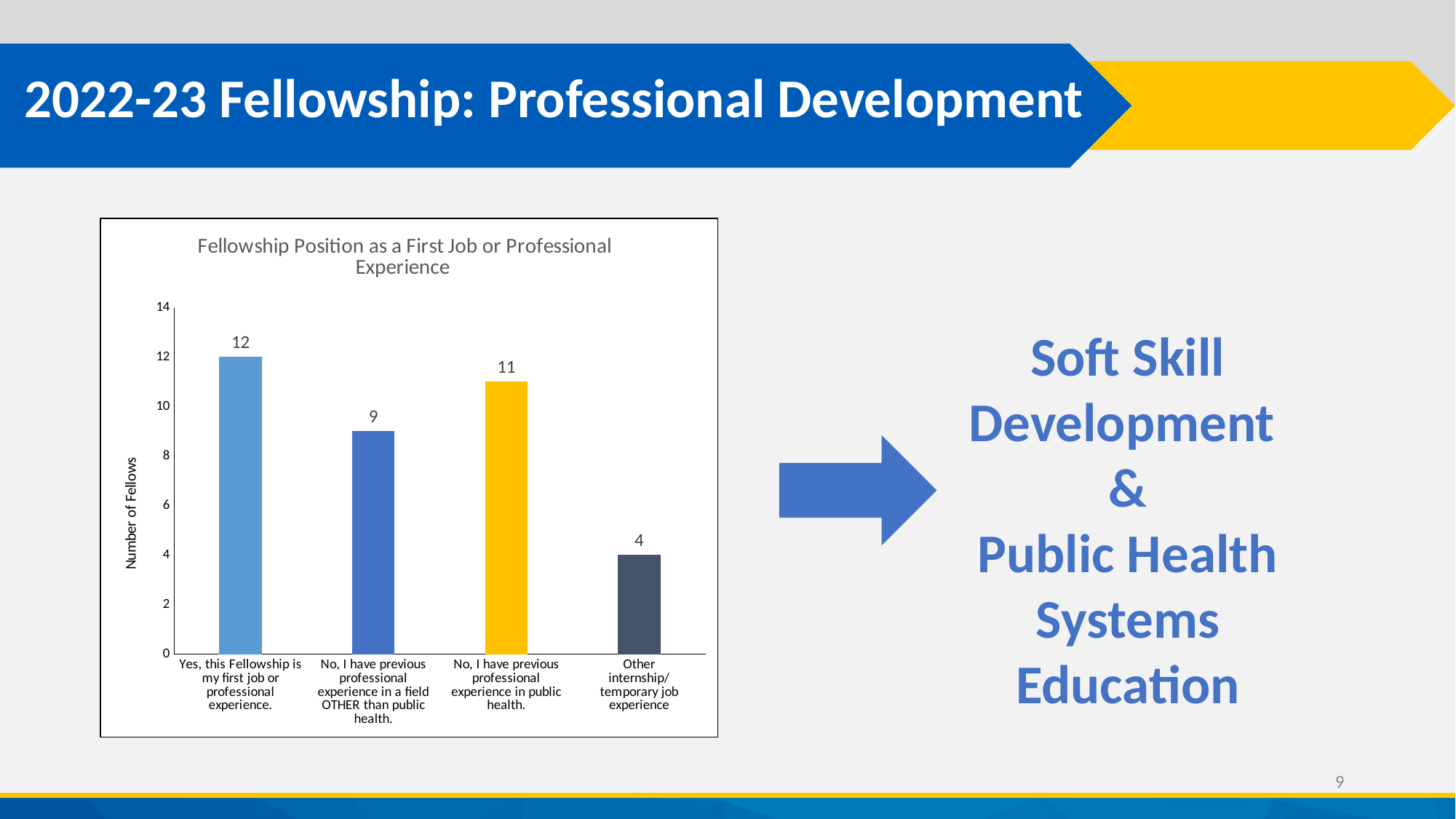
How many fellows reported previous professional experience in public health? 11 What is the title of the chart? Fellowship Position as a First Job or Professional Experience What is the label of the vertical axis of the chart? Number of Fellows How many fellows said this Fellowship is their first job or professional experience? 12 Which is larger: the number of fellows with previous experience in public health or the number with previous experience in a field other than public health? Previous professional experience in public health Which category has the lowest number of fellows? Other internship/temporary job experience What kind of chart is shown on the slide? Bar chart How many categories are shown on the x axis of the chart? 4 How many fellows reported other internship/temporary job experience? 4 How many fellows reported previous professional experience in a field OTHER than public health? 9 What is the difference between the number of fellows for whom the Fellowship is their first job and those with other internship/temporary job experience? 8 Which category has the highest number of fellows? Yes, this Fellowship is my first job or professional experience.